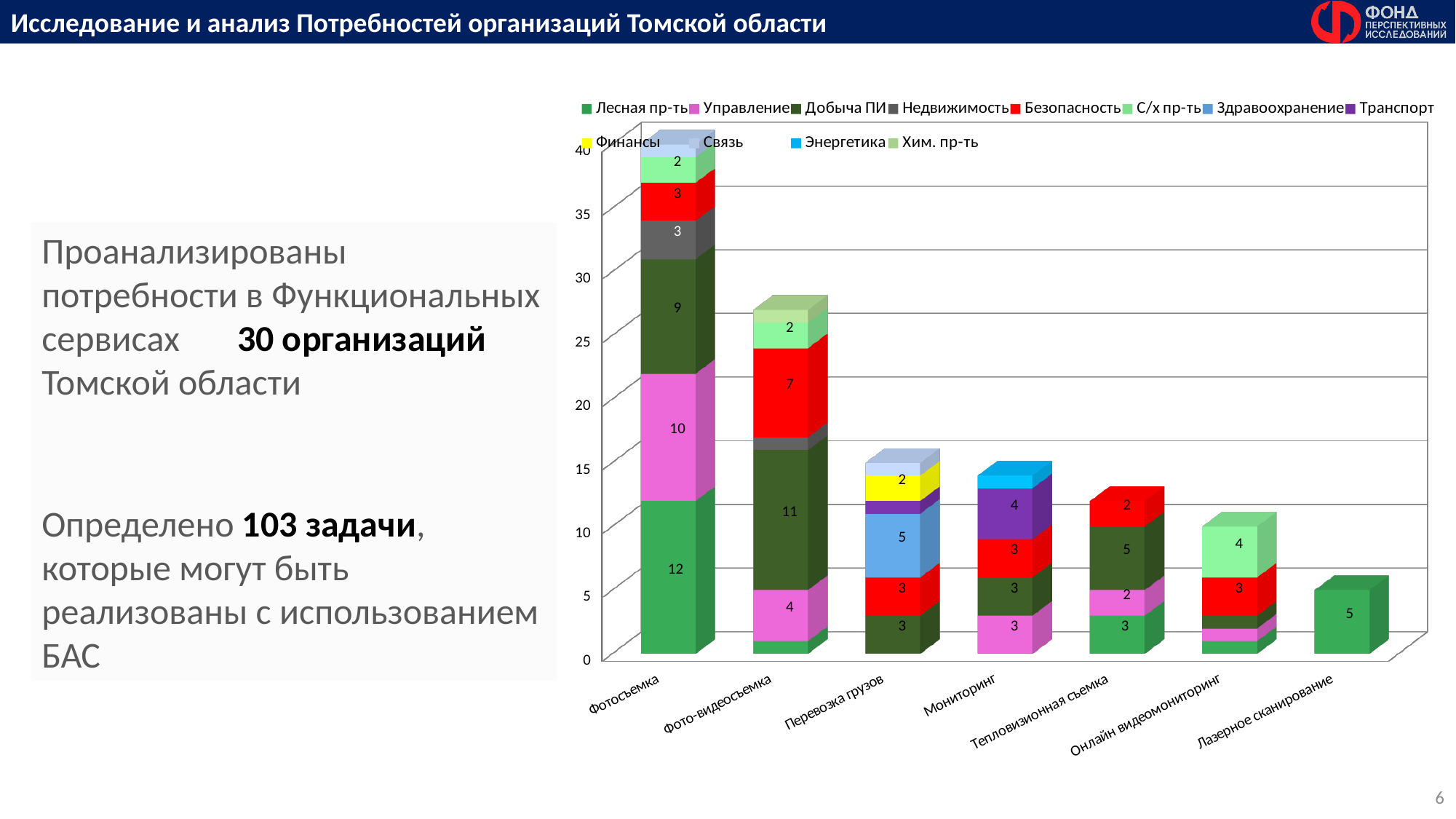
What is the difference between the Лесная пр-ть value for Фотосъемка and the Лесная пр-ть value for Лазерное сканирование? 7 What kind of chart is shown on the slide? Stacked bar chart Which category has the tallest stacked bar? Фотосъемка Is the total height of the Фотосъемка bar greater or less than 35? greater Which has the larger Добыча ПИ value: Фотосъемка or Фото-видеосъемка? Фото-видеосъемка How many categories are shown on the x axis? 7 What is the value for Лесная пр-ть in the Фотосъемка bar? 12 What is the value for Здравоохранение in the Перевозка грузов bar? 5 How many series does the legend list? 12 What is the value for Добыча ПИ in the Фото-видеосъемка bar? 11 Which category has the shortest stacked bar? Лазерное сканирование What is the value for Транспорт in the Мониторинг bar? 4